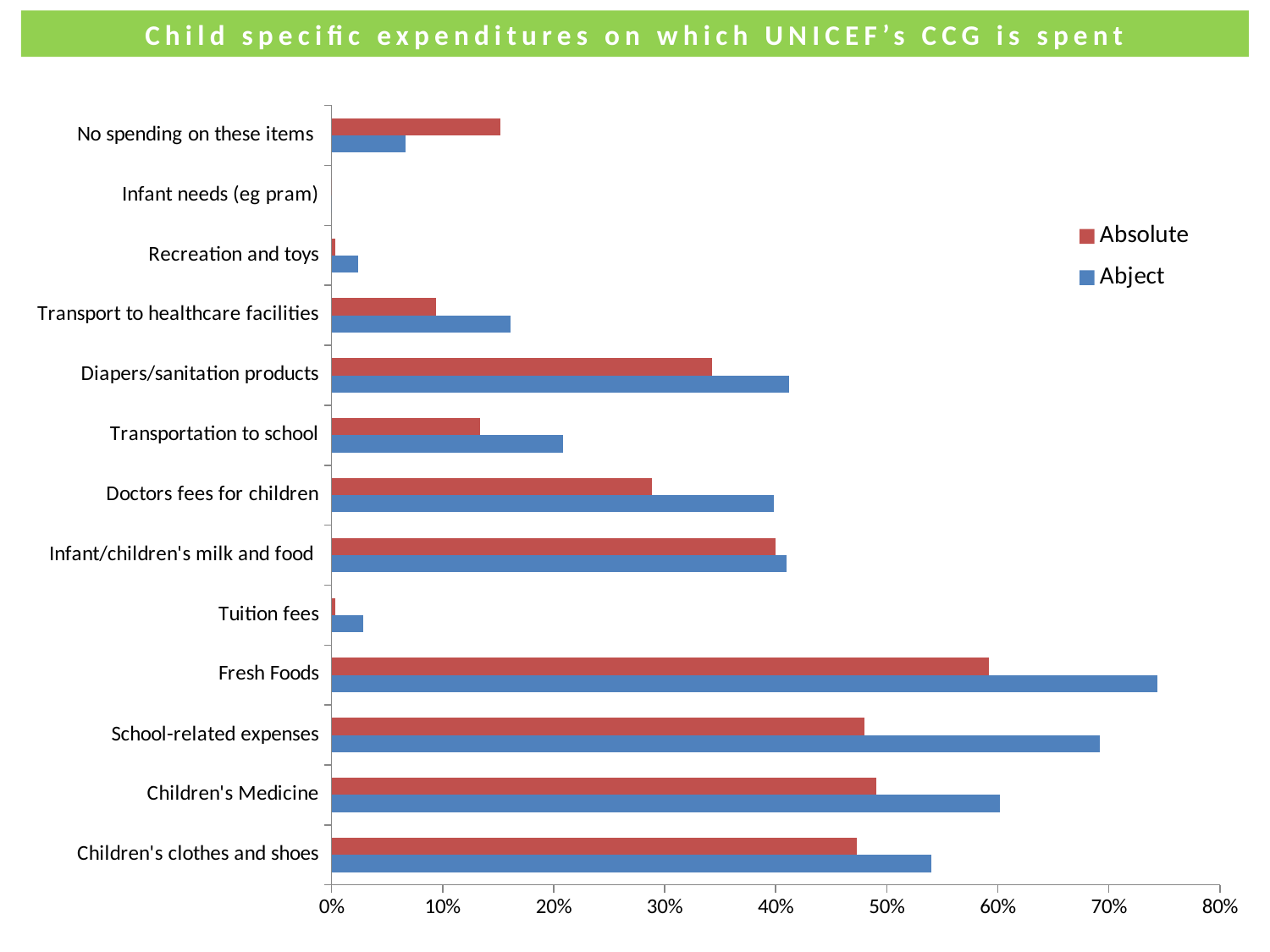
Is the Absolute value for Transportation to school greater or less than 20%? less Which category has the highest value for the Absolute series? Fresh Foods What kind of chart is shown on the slide? bar chart How many expenditure categories are shown on the chart? 13 Is the Abject value for Children's clothes and shoes greater or less than 50%? greater Which category has the highest value for the Abject series? Fresh Foods Is the Abject value for Fresh Foods greater or less than 70%? greater For No spending on these items, which series has the larger value, Absolute or Abject? Absolute For School-related expenses, which series has the larger value, Absolute or Abject? Abject Which category shows no bar for either series? Infant needs (eg pram) How many series does the legend list? 2